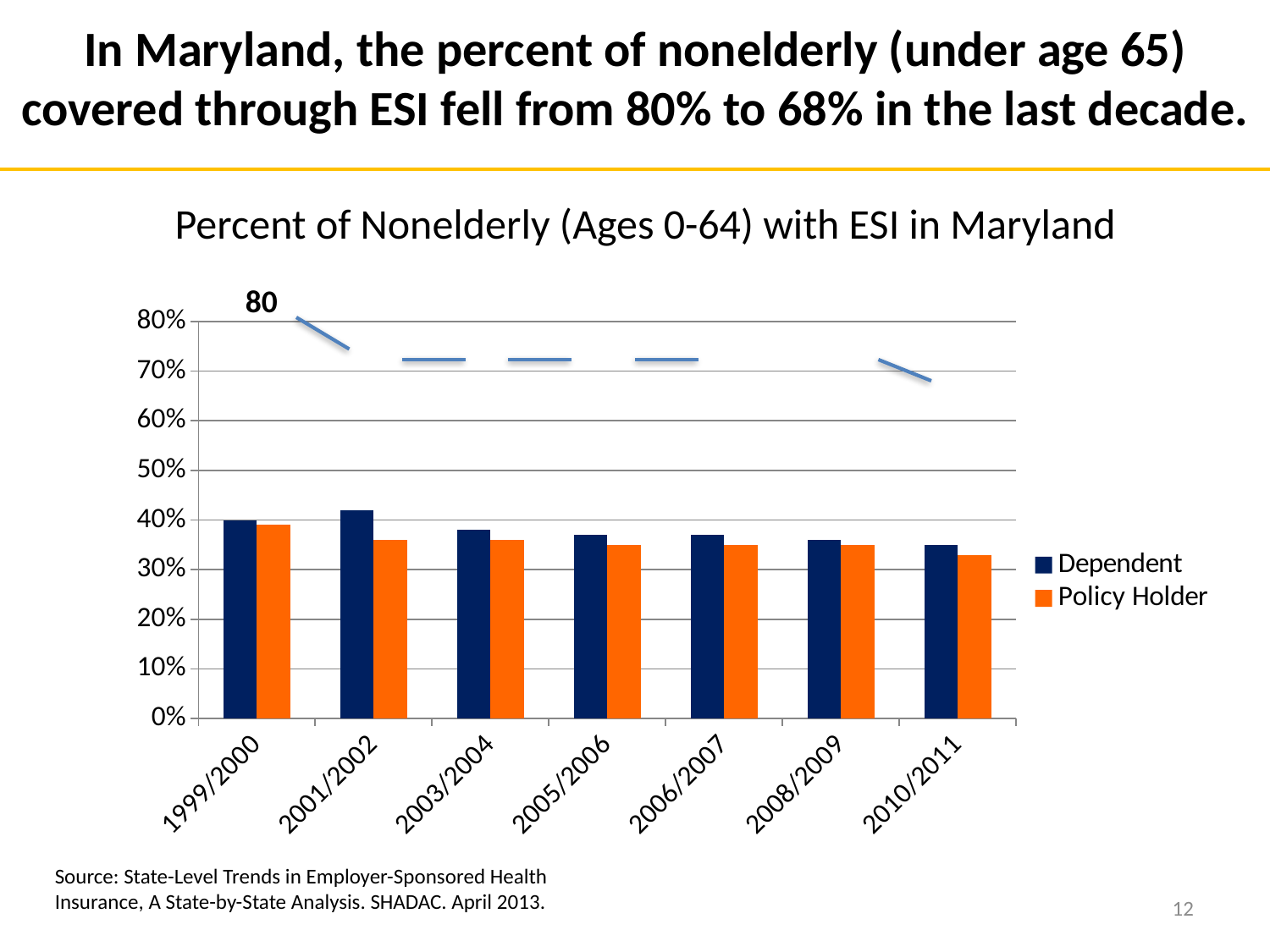
Do the Policy Holder values generally rise or fall from 1999/2000 to 2010/2011? Fall In 2001/2002, which is larger: Dependent or Policy Holder? Dependent Is the Dependent value for 2001/2002 greater or less than 40%? greater What is the title of the chart? Percent of Nonelderly (Ages 0-64) with ESI in Maryland In which period is the Policy Holder value highest? 1999/2000 In which period is the Dependent value highest? 2001/2002 Is the Policy Holder value for 2010/2011 greater or less than 30%? greater In which period is the Policy Holder value lowest? 2010/2011 How many time periods are shown on the x axis? 7 What kind of chart is shown on the slide? Bar chart How many series does the legend list? 2 Is the Dependent value for 2010/2011 greater or less than 40%? less